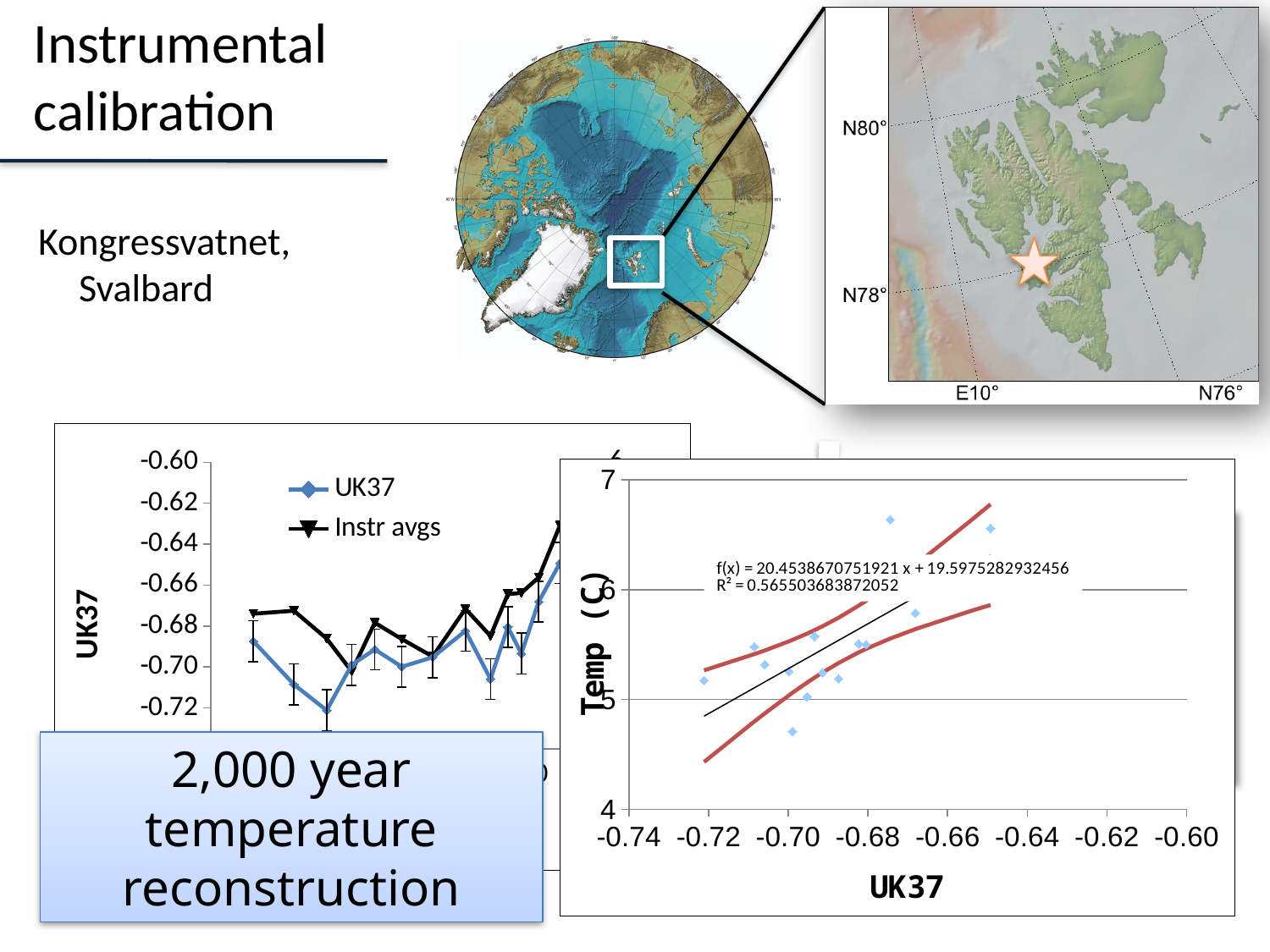
What kind of chart is the chart on the left with the UK37 and Instr avgs series? line chart In the left chart, does the UK37 series rise or fall over the last few points at the right end of the x axis? rise In the right scatter plot, is the highest temperature point greater or less than 6? greater What are the two series named in the legend of the left chart? UK37 and Instr avgs In the right scatter plot, is the lowest temperature point greater or less than 5? less In the right scatter plot, what is the equation of the fitted line shown on the chart? f(x) = 20.4538670751921 x + 19.5975282932456 What is the y-axis label of the right scatter plot? Temp (C) In the right scatter plot, what is the slope of the fitted line? 20.4538670751921 In the right scatter plot, does temperature tend to rise or fall as UK37 increases along the x axis? rise How many series does the legend of the left chart list? 2 In the right scatter plot, what is the R² value shown for the fitted line? 0.565503683872052 What kind of chart is the chart on the right with UK37 on the x axis? scatter plot